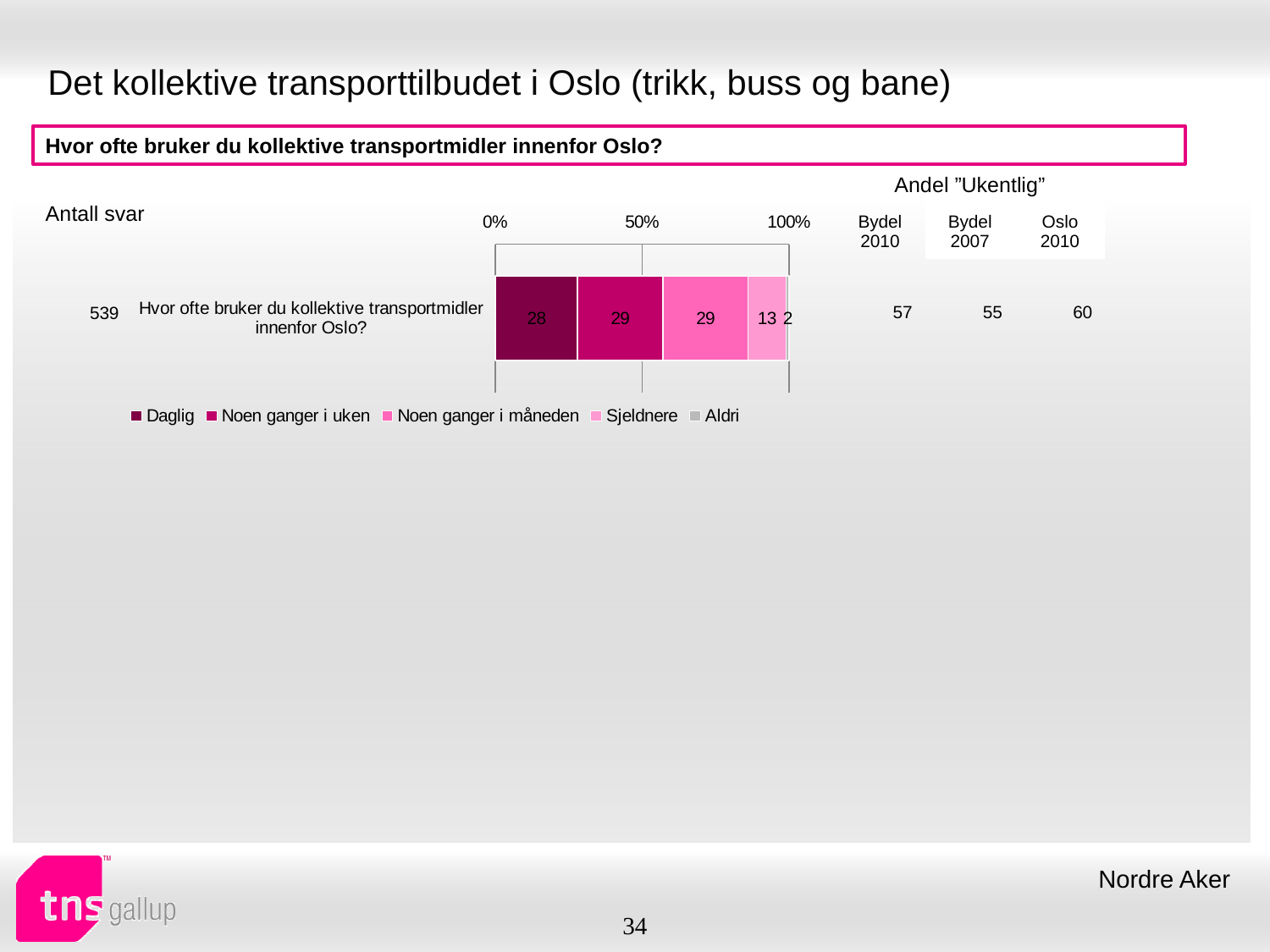
What is the difference between the "Daglig" value and the "Sjeldnere" value? 15 Which series has the smallest segment in the bar? Aldri How many series does the legend list? 5 What is the value for "Aldri" in the bar? 2 What is the total of the "Daglig" and "Noen ganger i uken" segments? 57 What is the value for "Noen ganger i uken" in the bar? 29 What is the value for "Daglig" in the bar? 28 What is the value for "Noen ganger i måneden" in the bar? 29 What is the value for "Sjeldnere" in the bar? 13 What is the last entry in the chart legend? Aldri Which is larger, the "Daglig" segment or the "Sjeldnere" segment? Daglig What kind of chart is shown on the slide? Stacked bar chart